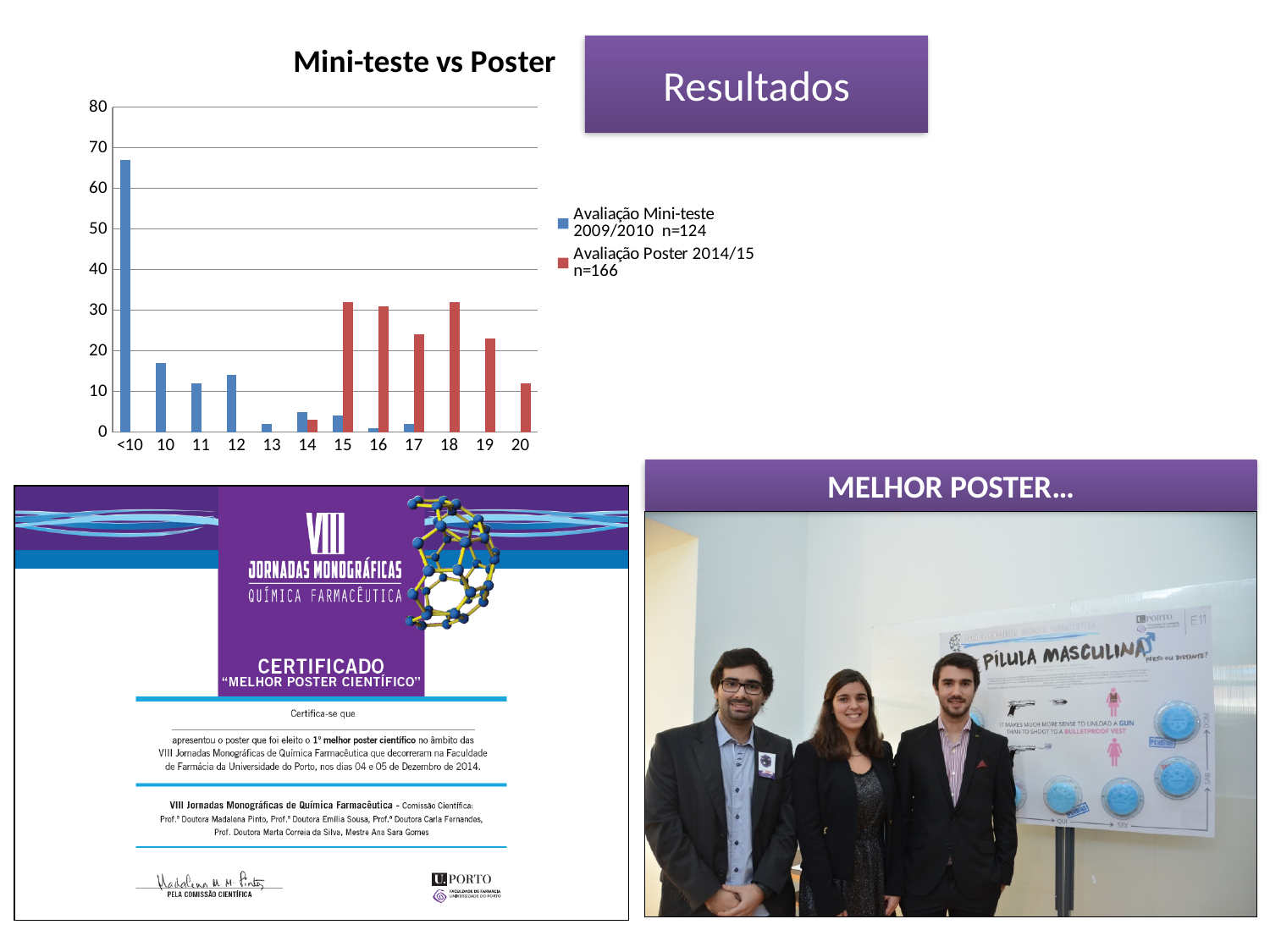
What kind of chart is shown under the title "Mini-teste vs Poster"? bar chart What colour are the bars for the Avaliação Mini-teste 2009/2010 series in the "Mini-teste vs Poster" chart? blue In the "Mini-teste vs Poster" chart, is the Avaliação Poster 2014/15 value for 20 greater or less than 20? less In the "Mini-teste vs Poster" chart, is the Avaliação Mini-teste 2009/2010 value for 10 greater or less than 20? less In the "Mini-teste vs Poster" chart, is the Avaliação Mini-teste 2009/2010 value for <10 greater or less than 60? greater What is the sample size (n) given in the legend for the Avaliação Poster 2014/15 series? n=166 In the "Mini-teste vs Poster" chart, which is larger for category 12: the Avaliação Mini-teste 2009/2010 value or the Avaliação Poster 2014/15 value? Avaliação Mini-teste 2009/2010 In the "Mini-teste vs Poster" chart, which category has the highest value for the Avaliação Mini-teste 2009/2010 series? <10 In the "Mini-teste vs Poster" chart, which is larger for category 17: the Avaliação Mini-teste 2009/2010 value or the Avaliação Poster 2014/15 value? Avaliação Poster 2014/15 How many series does the legend of the "Mini-teste vs Poster" chart list? 2 How many categories are shown on the x axis of the "Mini-teste vs Poster" chart? 12